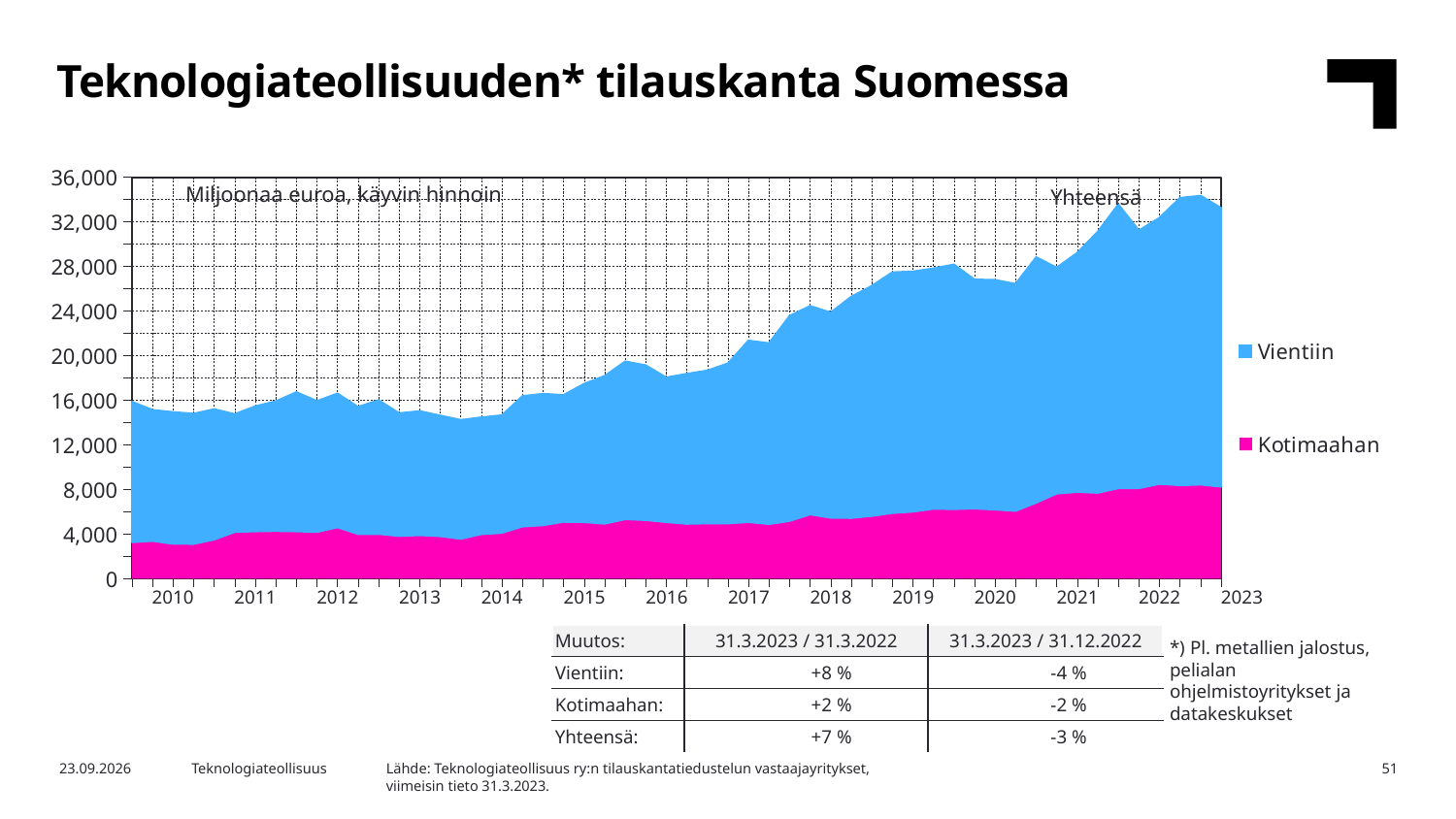
Is the Kotimaahan value at the start of 2010 greater or less than 4,000? less Is the total (Yhteensä) value at the 2022 peak greater or less than 32,000? greater Does the total order backlog (Yhteensä) generally rise or fall from 2010 to 2023? rise What kind of chart is shown on the slide? Area chart Which series is larger throughout the chart, Vientiin or Kotimaahan? Vientiin What unit is stated in the label at the top of the chart? Miljoonaa euroa, käyvin hinnoin Is the total (Yhteensä) value in 2013 greater or less than 16,000? less Which two series are listed in the chart legend? Vientiin and Kotimaahan How many year labels are shown on the x axis? 14 How many series does the chart legend list? 2